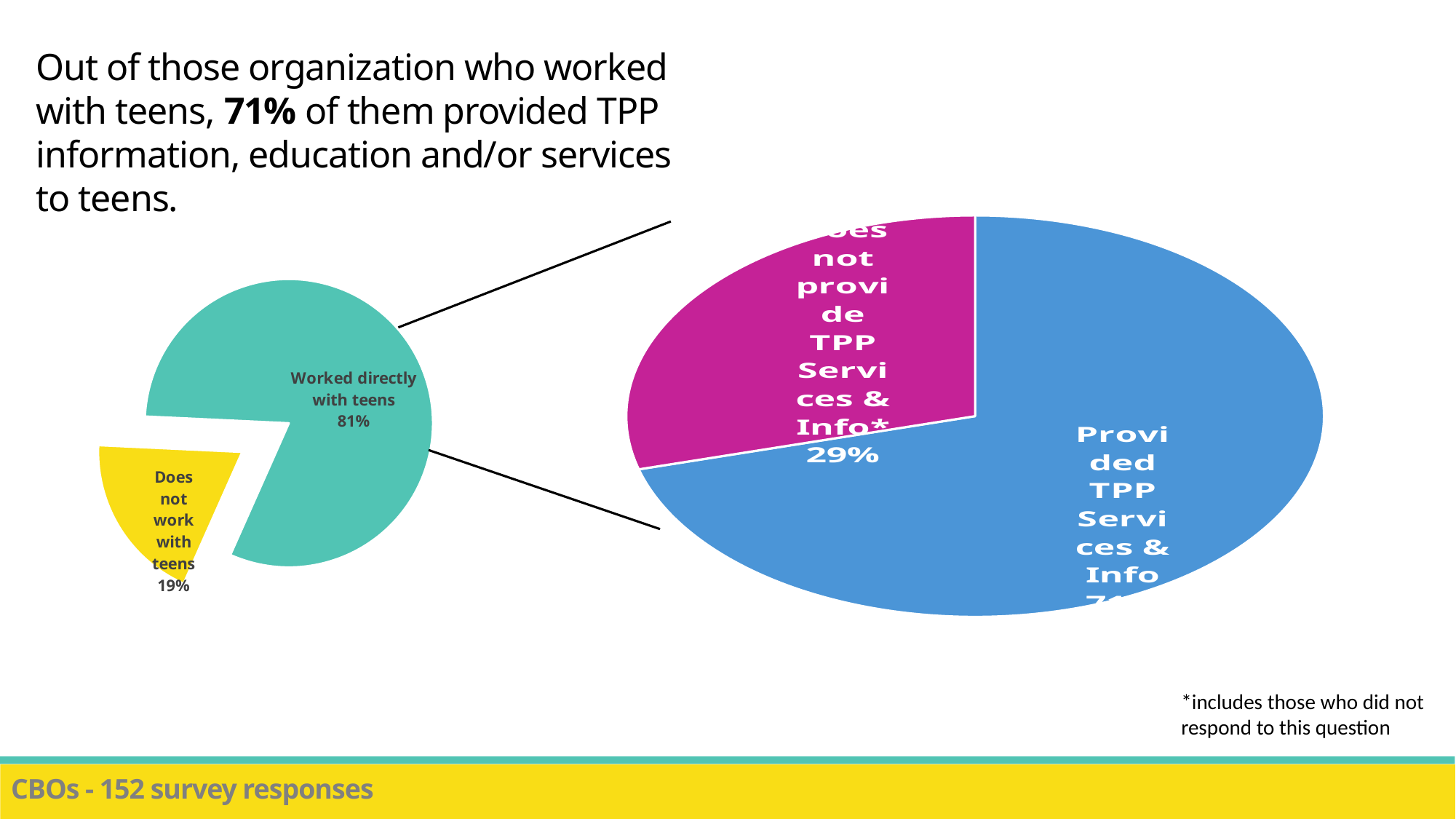
What colour is the 'Does not work with teens' slice in the left pie chart? Yellow In the right pie chart, what percentage does not provide TPP Services & Info? 29% In the left pie chart, what percentage of organizations does not work with teens? 19% In the right pie chart, which category has the smallest share? Does not provide TPP Services & Info* What type of chart is the chart on the right side of the slide? Pie chart In the right pie chart, what percentage provided TPP Services & Info? 71% In the left pie chart, what percentage of organizations worked directly with teens? 81% In the right pie chart, what is the difference in percentage points between those that provided TPP Services & Info and those that did not? 42 In the left pie chart, which is larger: the share that worked directly with teens or the share that does not work with teens? Worked directly with teens How many slices does the left pie chart have? 2 In the left pie chart, what is the difference in percentage points between organizations that worked directly with teens and those that do not work with teens? 62 In the left pie chart, which category has the largest share? Worked directly with teens